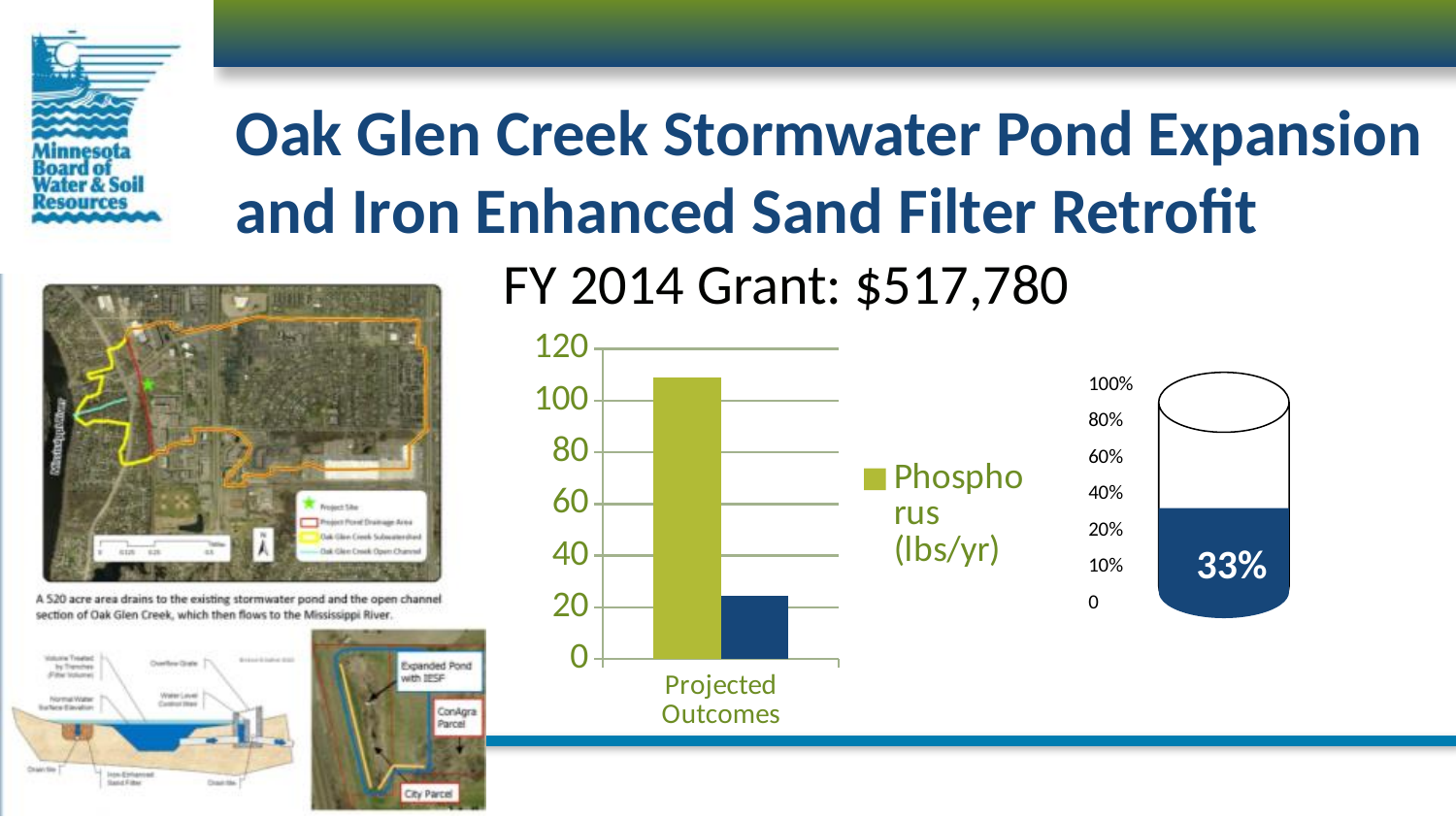
In the bar chart, which bar is taller, the green Phosphorus (lbs/yr) bar or the blue bar? the green Phosphorus (lbs/yr) bar What is the category label on the x axis of the bar chart? Projected Outcomes How many categories are shown on the x axis of the bar chart? 1 Is the value of the green Phosphorus (lbs/yr) bar greater or less than 100? greater Is the value of the blue bar in the bar chart greater or less than 20? greater Is the value of the green Phosphorus (lbs/yr) bar greater or less than 120? less What kind of chart is shown in the middle of the slide? bar chart What is the highest value shown on the y axis of the bar chart? 120 What series name appears in the legend of the bar chart? Phosphorus (lbs/yr) How many series does the legend of the bar chart list? 1 What percentage is labelled on the filled cylinder graphic on the right of the slide? 33%